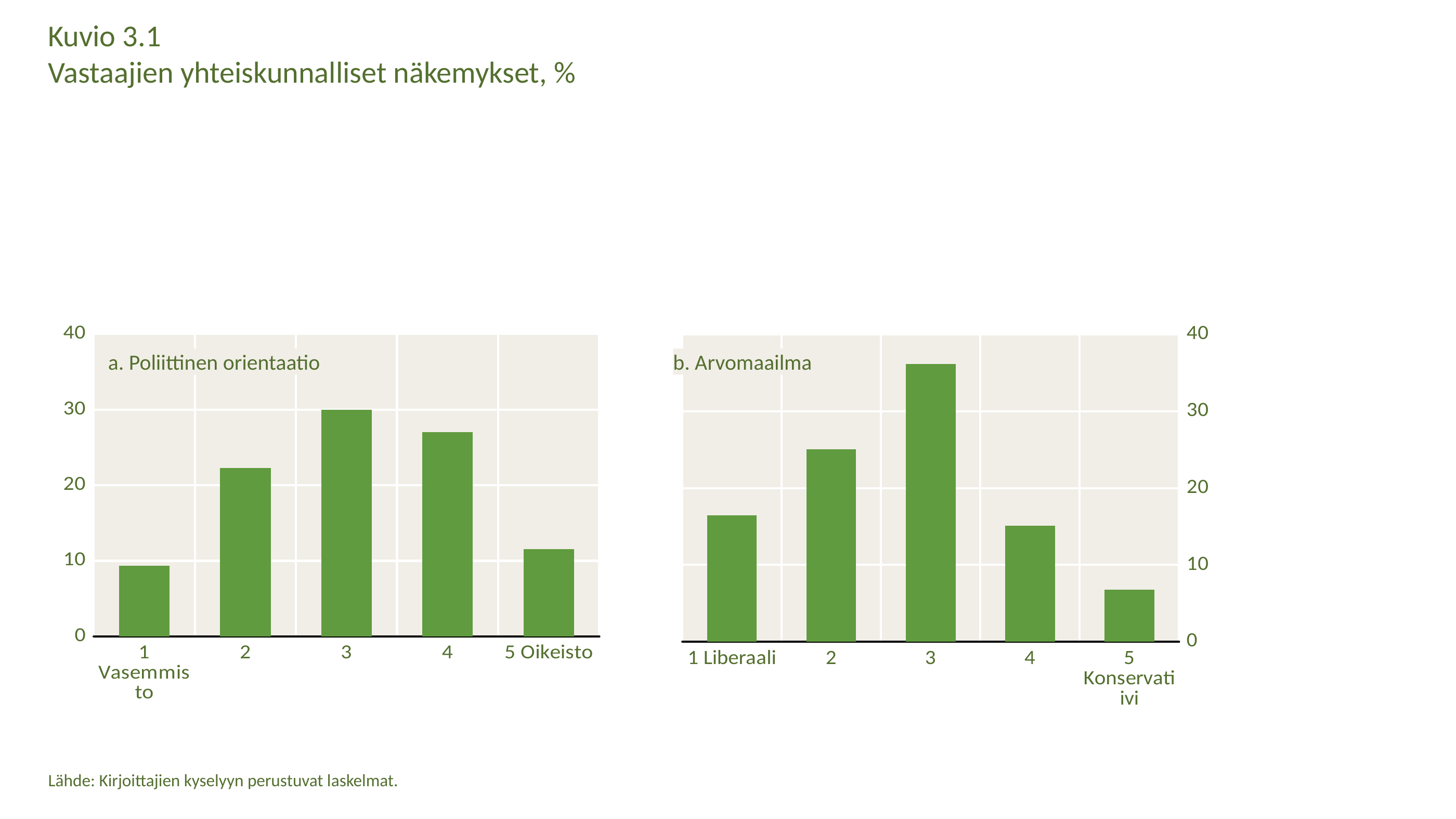
How many categories are shown in the chart "a. Poliittinen orientaatio"? 5 In the chart "a. Poliittinen orientaatio", which category has the lowest value? 1 Vasemmisto In the chart "a. Poliittinen orientaatio", is the value for category 2 greater or less than 20? greater In the chart "a. Poliittinen orientaatio", which is larger, the value for category 2 or category 4? 4 In the chart "b. Arvomaailma", is the value for category 3 greater or less than 30? greater In the chart "a. Poliittinen orientaatio", is the value for "5 Oikeisto" greater or less than 20? less In the chart "b. Arvomaailma", which category has the lowest value? 5 Konservatiivi In the chart "b. Arvomaailma", which is larger, the value for "1 Liberaali" or category 2? 2 In the chart "b. Arvomaailma", which category has the highest value? 3 What kind of chart is "a. Poliittinen orientaatio"? bar chart In the chart "a. Poliittinen orientaatio", which category has the highest value? 3